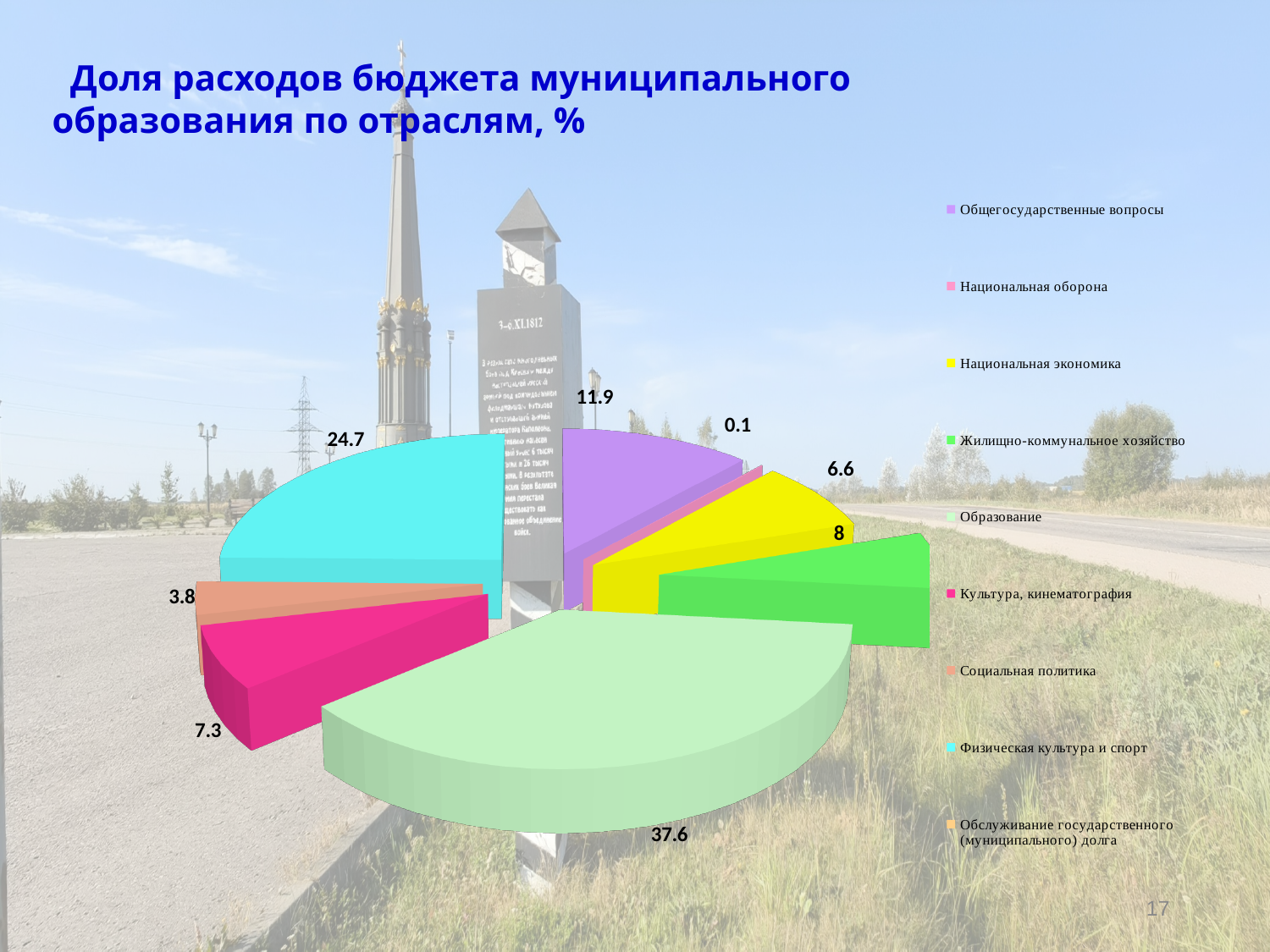
What is the title of the slide? Доля расходов бюджета муниципального образования по отраслям, % What is the value for Общегосударственные вопросы? 11.9 What kind of chart is shown on the slide? Pie chart Which is larger, Культура, кинематография or Национальная экономика? Национальная экономика What is the value for Образование? 37.6 What is the value for Жилищно-коммунальное хозяйство? 6.6 What is the value for Социальная политика? 3.8 What is the difference between the values for Образование and Физическая культура и спорт? 12.9 How many entries does the legend list? 9 Which labelled slice has the smallest value? Национальная оборона Which category has the largest share of the pie? Образование What is the value for Физическая культура и спорт? 24.7